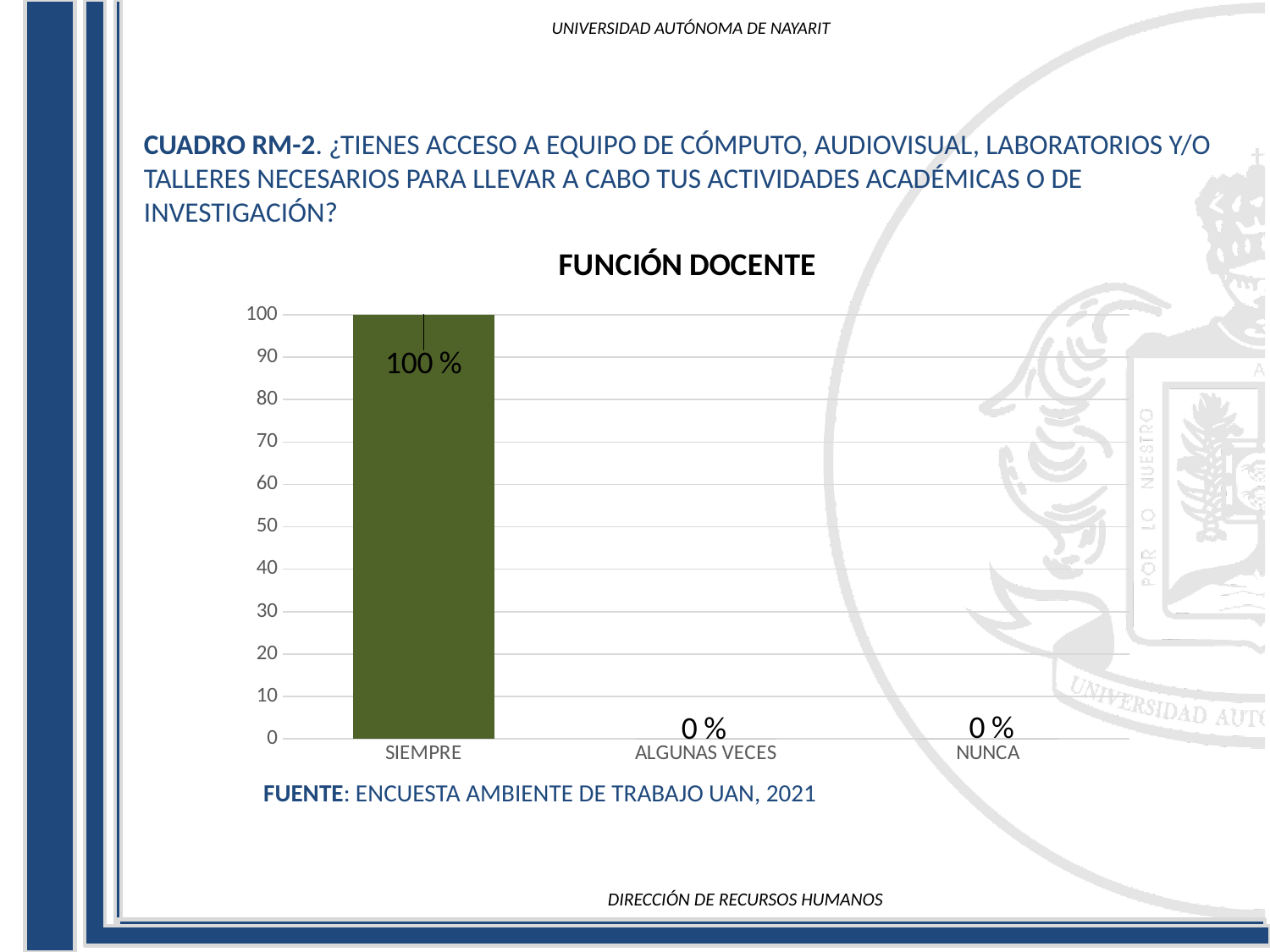
What is the source cited below the chart? ENCUESTA AMBIENTE DE TRABAJO UAN, 2021 Is the value for SIEMPRE greater or less than 50? greater Which is larger, the value for SIEMPRE or the value for ALGUNAS VECES? SIEMPRE What is the difference between the values for SIEMPRE and NUNCA? 100 % How many categories are shown on the x axis? 3 What is the highest tick value shown on the y axis? 100 What is the value for NUNCA? 0 % Which category has the highest value? SIEMPRE What is the title of the chart? FUNCIÓN DOCENTE What is the value for ALGUNAS VECES? 0 % What kind of chart is shown? bar chart What is the value for SIEMPRE? 100 %